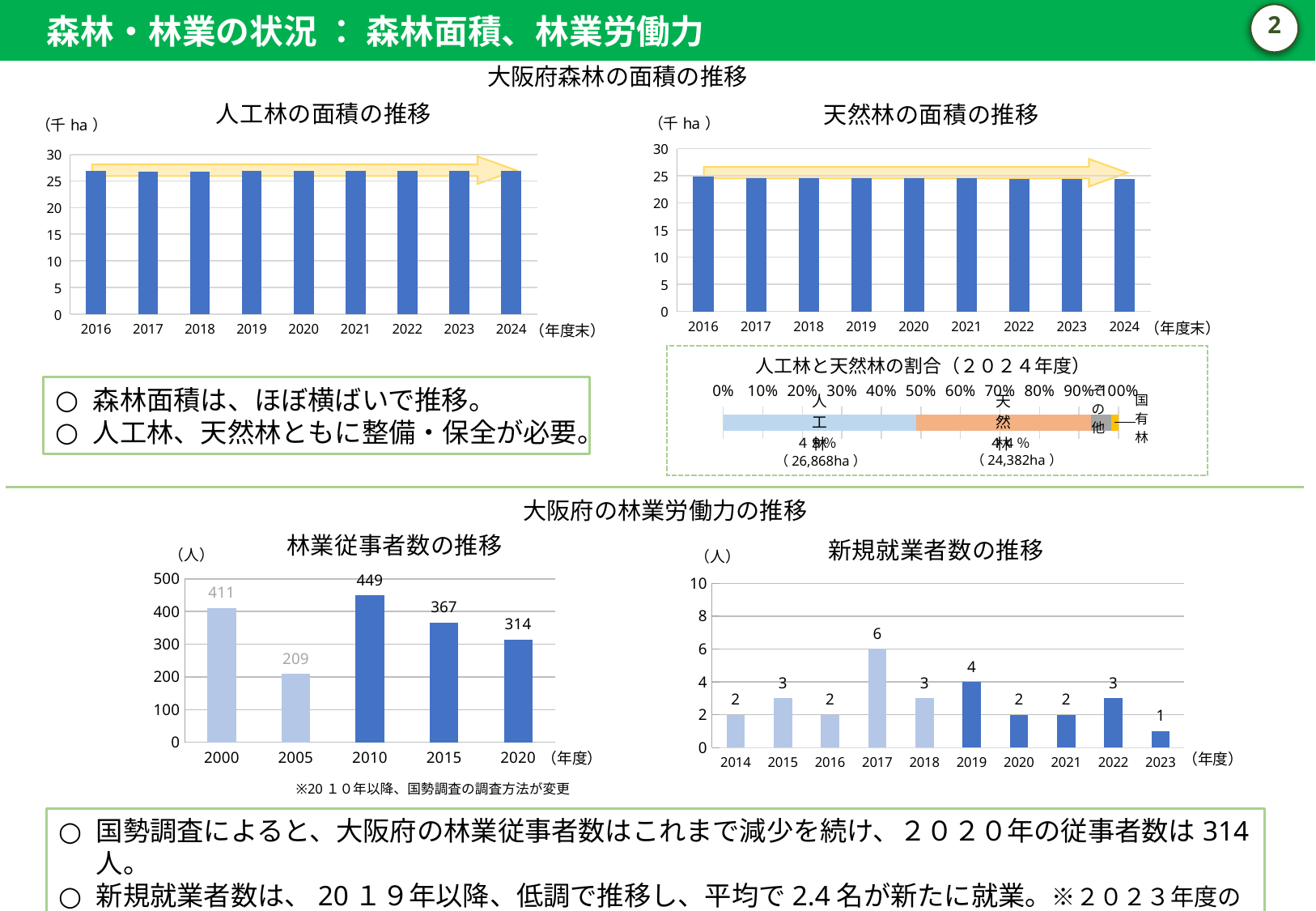
In the 林業従事者数の推移 chart, what is the value for 2010? 449 In the 林業従事者数の推移 chart, which year has the lowest value? 2005 In the 人工林の面積の推移 chart, is the value for 2024 greater or less than 25? greater In the 新規就業者数の推移 chart, how many years are plotted? 10 In the 天然林の面積の推移 chart, is the value for 2016 greater or less than 20? greater In the 新規就業者数の推移 chart, which is larger, the value for 2022 or the value for 2023? 2022 In the 林業従事者数の推移 chart, what is the value for 2020? 314 In the 林業従事者数の推移 chart, what is the difference between the values for 2015 and 2020? 53 In the 新規就業者数の推移 chart, which year has the highest value? 2017 In the 新規就業者数の推移 chart, what is the value for 2019? 4 What kind of chart is the 人工林の面積の推移 chart? bar chart In the 林業従事者数の推移 chart, how many years are plotted? 5